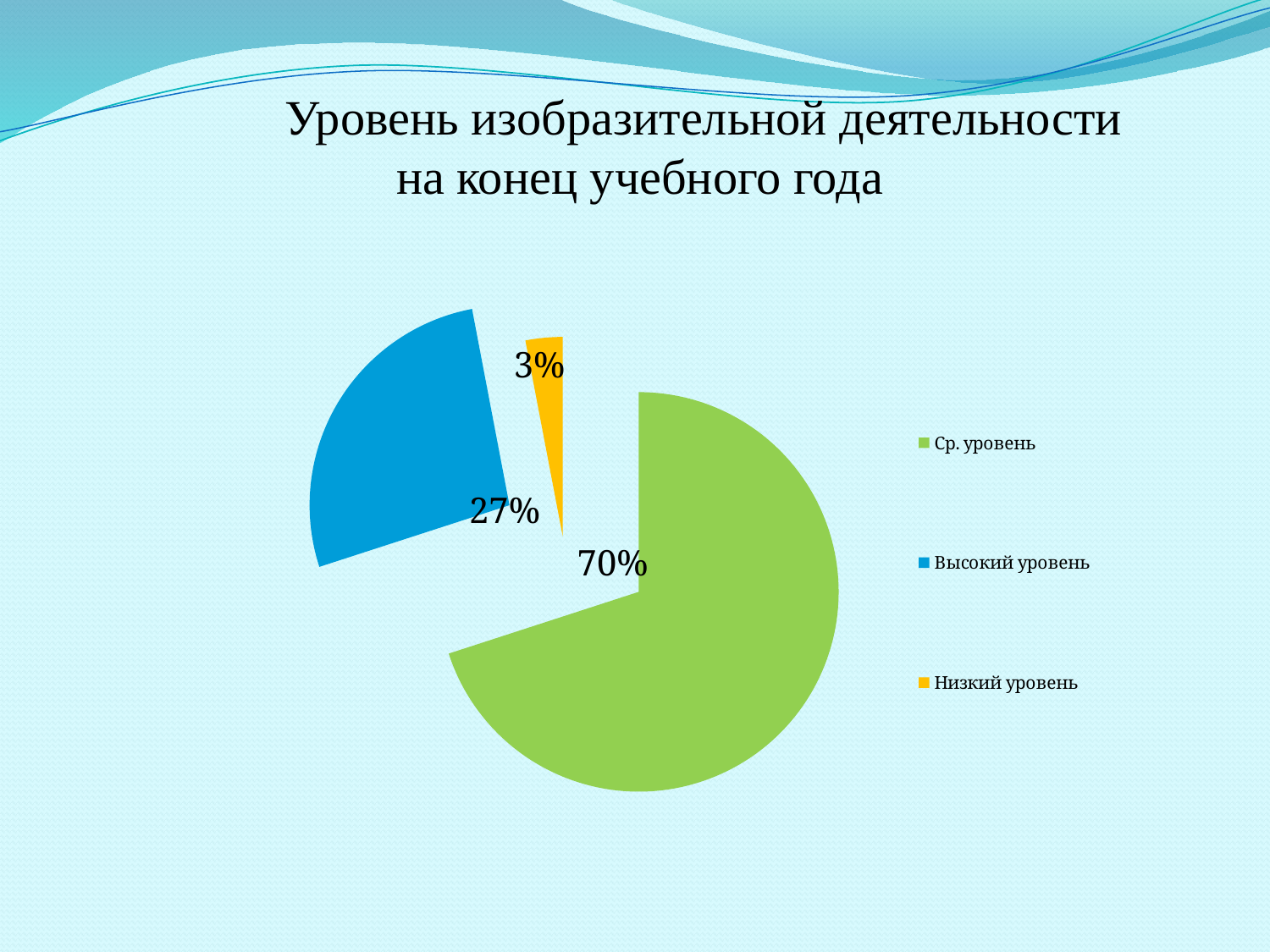
What is the difference between the shares of "Высокий уровень" and "Низкий уровень"? 24% How many categories does the pie chart have? 3 Which category has the smallest slice of the pie? Низкий уровень What share of the pie does "Высокий уровень" have? 27% What share of the pie does "Низкий уровень" have? 3% What kind of chart is shown on the slide? pie chart Which category has the largest slice of the pie? Ср. уровень Which is larger, the share of "Высокий уровень" or the share of "Низкий уровень"? Высокий уровень What is the title of the slide? Уровень изобразительной деятельности на конец учебного года What is the difference between the shares of "Ср. уровень" and "Высокий уровень"? 43% What colour is the slice for "Низкий уровень"? yellow What share of the pie does "Ср. уровень" have? 70%